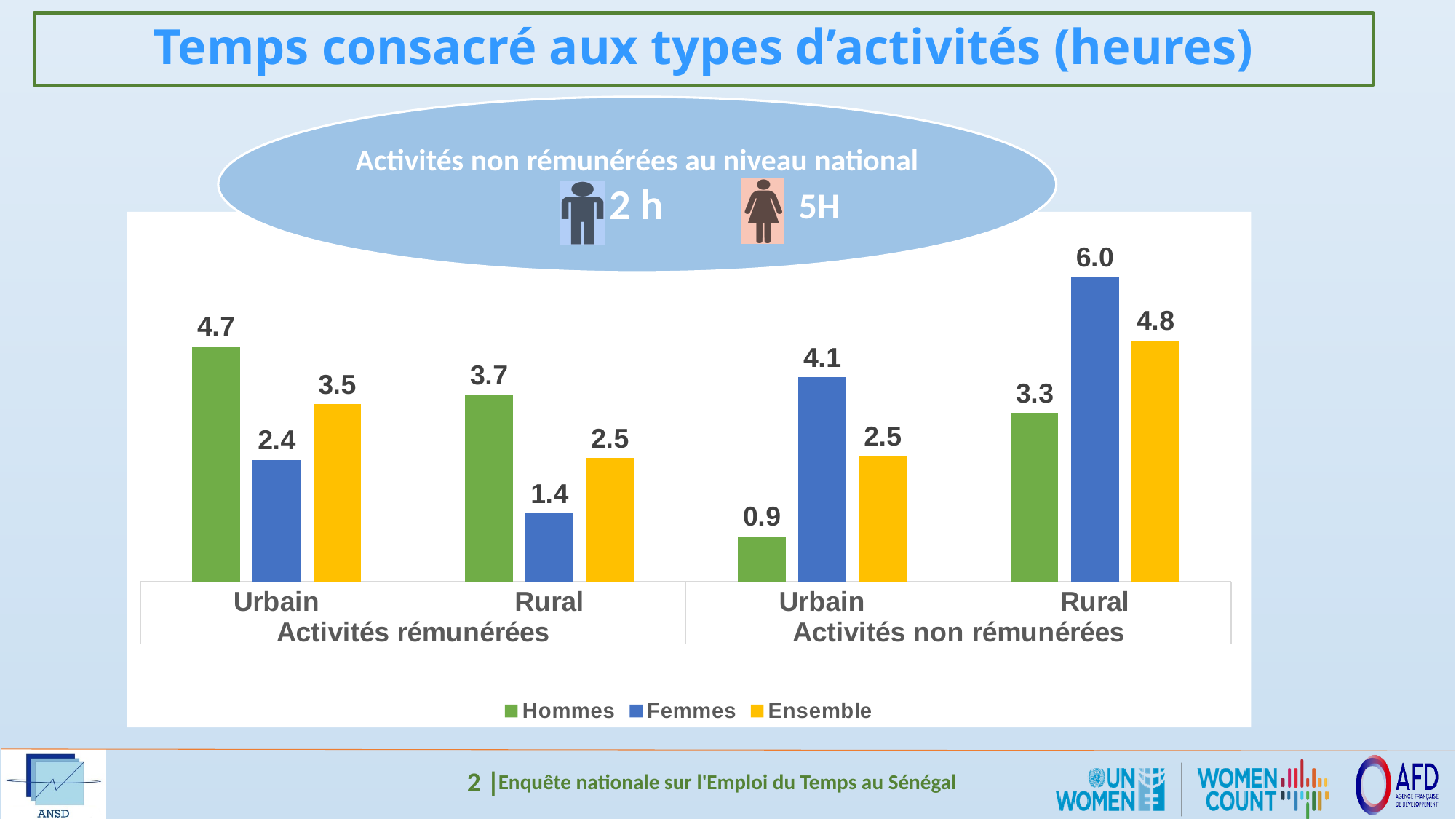
Which colour represents the Ensemble series in the legend? Yellow What kind of chart is shown on the slide? Bar chart What is the value for Femmes in Rural under Activités non rémunérées? 6.0 Which bar has the highest value on the chart? Femmes, Rural, Activités non rémunérées (6.0) What is the value for Ensemble in Urbain under Activités non rémunérées? 2.5 Which is larger for Rural under Activités non rémunérées: Hommes or Femmes? Femmes Which bar has the lowest value on the chart? Hommes, Urbain, Activités non rémunérées (0.9) What is the difference between Femmes and Ensemble in Rural under Activités non rémunérées? 1.2 How many series does the legend list? 3 What is the difference between Hommes and Femmes in Urbain under Activités rémunérées? 2.3 What is the value for Femmes in Rural under Activités rémunérées? 1.4 What is the value for Hommes in Urbain under Activités rémunérées? 4.7